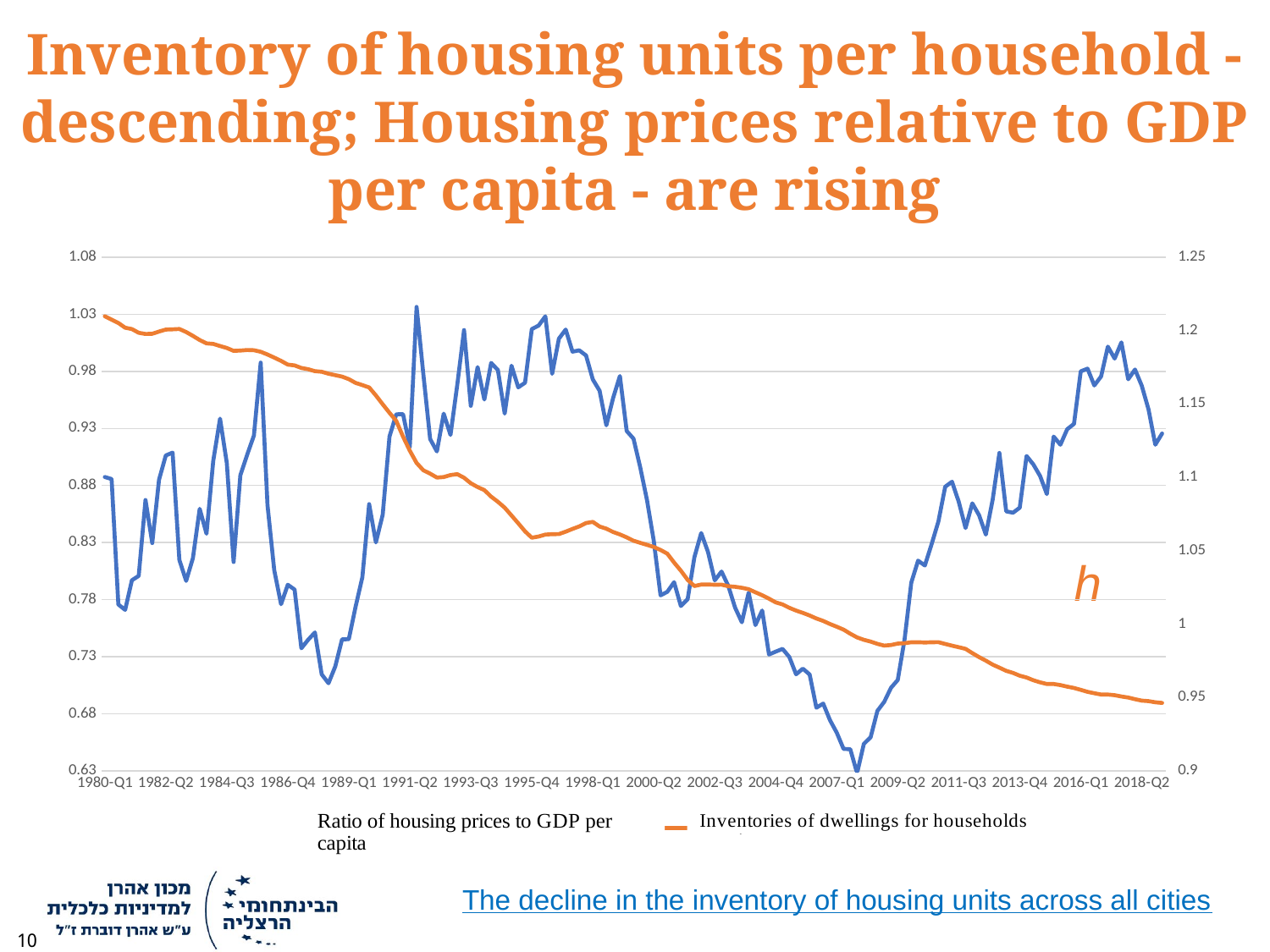
Is the highest value of the blue line (Ratio of housing prices to GDP per capita) greater or less than 0.98 on the left axis? greater What is the highest value shown on the left vertical axis? 1.08 Is the value of the orange line (Inventories of dwellings for households) at 1980-Q1 greater or less than 1.15 on the right axis? greater Does the orange line (Inventories of dwellings for households) rise or fall from 1980-Q1 to 2018-Q2? Fall Is the value of the orange line (Inventories of dwellings for households) at 2018-Q2 greater or less than 1 on the right axis? less What kind of chart is shown on the slide? Line chart Near which x-axis label does the blue line (Ratio of housing prices to GDP per capita) reach its lowest point? 2007-Q1 How many date labels are shown along the x axis? 18 Does the blue line (Ratio of housing prices to GDP per capita) rise or fall between 2007-Q1 and 2016-Q1? Rise How many series does the legend list? 2 Which series is drawn in orange? Inventories of dwellings for households